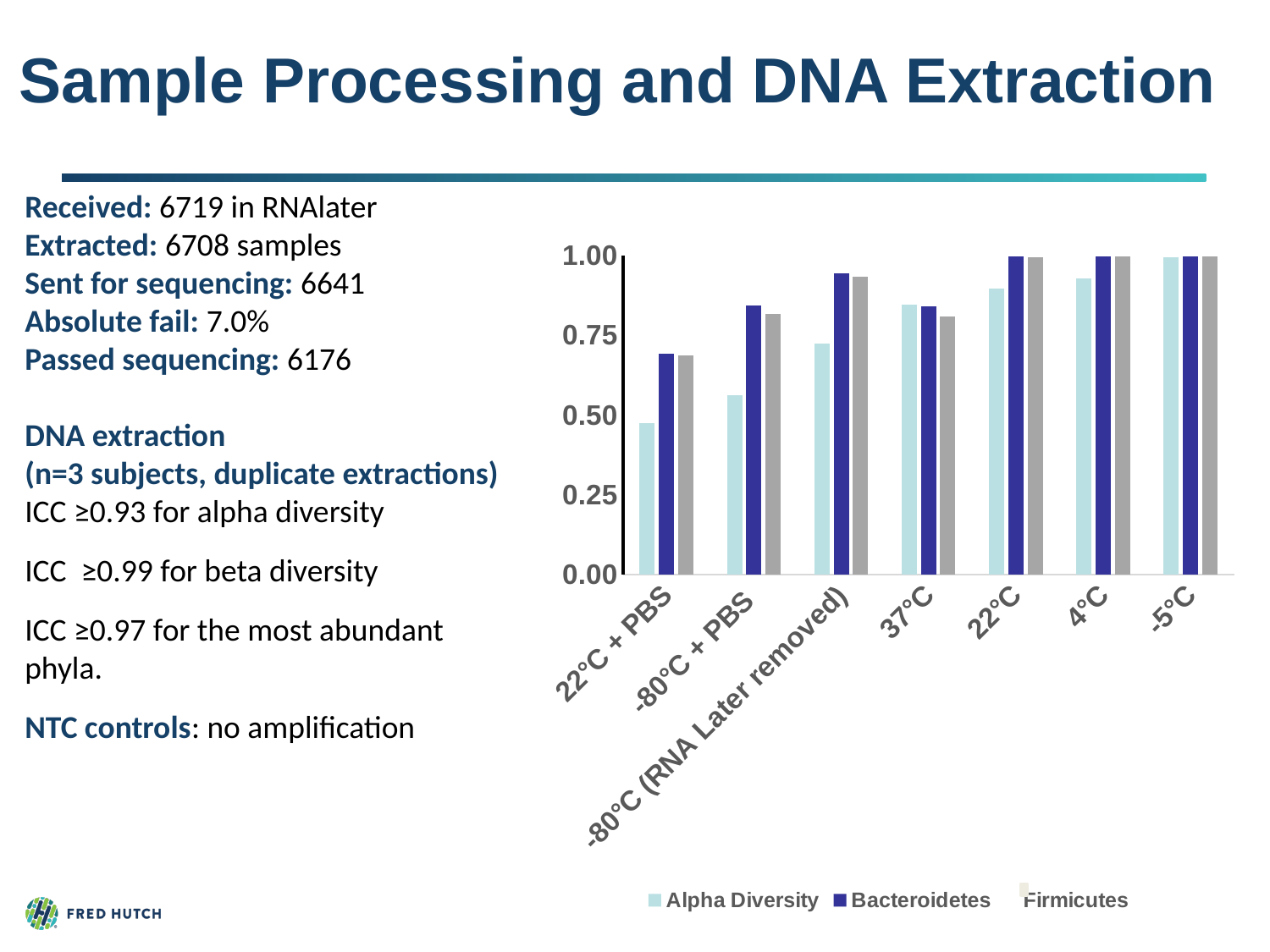
How many categories are shown on the x axis of the chart? 7 What are the three series named in the chart's legend? Alpha Diversity, Bacteroidetes, Firmicutes How many series does the chart's legend list? 3 What kind of chart is shown on the slide? bar chart Is the Bacteroidetes value for -80°C + PBS greater or less than 0.75? greater Is the Alpha Diversity value for 37°C greater or less than 0.75? greater Which category has the lowest Alpha Diversity value? 22°C + PBS For 22°C + PBS, which is larger, the Alpha Diversity value or the Bacteroidetes value? Bacteroidetes Is the Alpha Diversity value for -80°C + PBS greater or less than 0.50? greater Which is larger, the Alpha Diversity value for 22°C + PBS or for -80°C + PBS? -80°C + PBS Do the Alpha Diversity values generally rise or fall from left to right along the x axis? rise